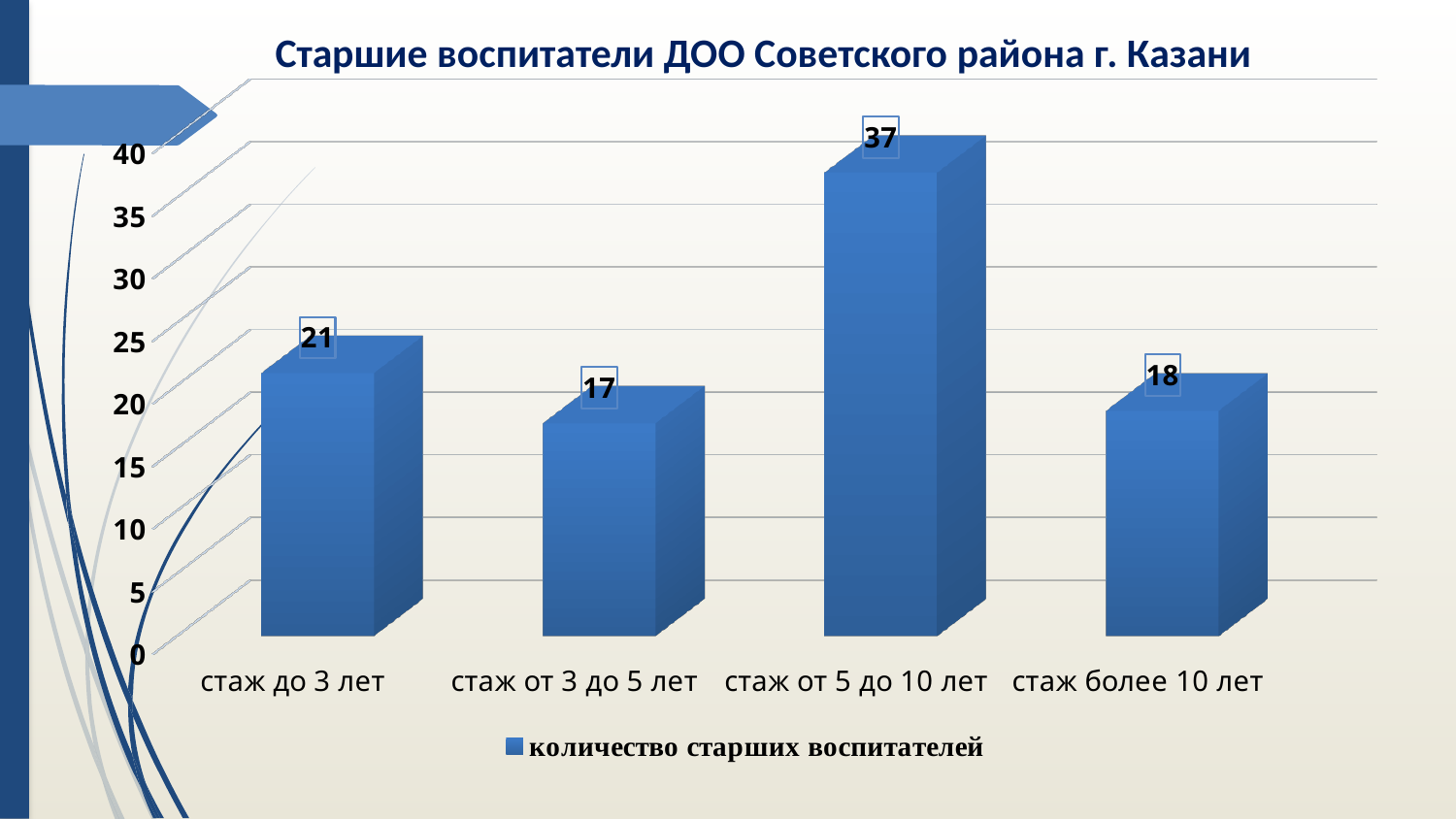
Which is larger: the value for "стаж до 3 лет" or "стаж более 10 лет"? стаж до 3 лет What is the difference between the values for "стаж от 5 до 10 лет" and "стаж до 3 лет"? 16 Which category has the lowest value? стаж от 3 до 5 лет What is the value for "стаж от 5 до 10 лет"? 37 What is the value for "стаж более 10 лет"? 18 Which category has the highest value? стаж от 5 до 10 лет What kind of chart is shown on the slide? bar chart What is the value for "стаж до 3 лет"? 21 How many series does the legend list? 1 What is the title of the chart? Старшие воспитатели ДОО Советского района г. Казани What is the value for "стаж от 3 до 5 лет"? 17 How many categories are shown on the x axis? 4